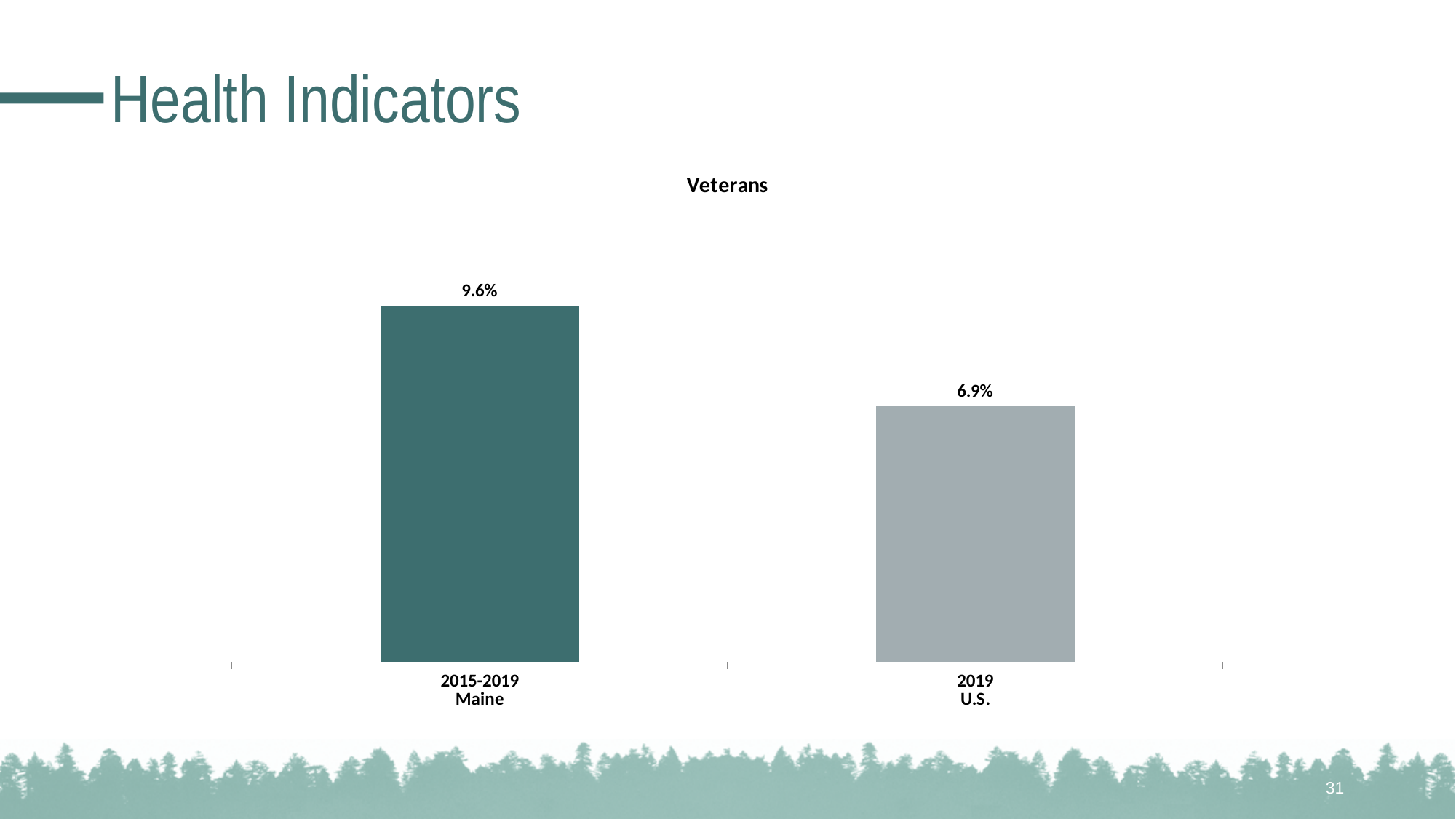
What is the difference between the Maine and U.S. values in the Veterans chart? 2.7% What is the title of the chart on the slide? Veterans Is the value for Maine larger or smaller than the value for the U.S. in the Veterans chart? larger What is the value for U.S. (2019) in the Veterans chart? 6.9% Which category has the higher value in the Veterans chart? 2015-2019 Maine What time period is shown for the Maine bar in the Veterans chart? 2015-2019 How many bars are shown in the Veterans chart? 2 What is the value for Maine (2015-2019) in the Veterans chart? 9.6% What type of chart is shown on the slide? bar chart Which category has the lower value in the Veterans chart? 2019 U.S.